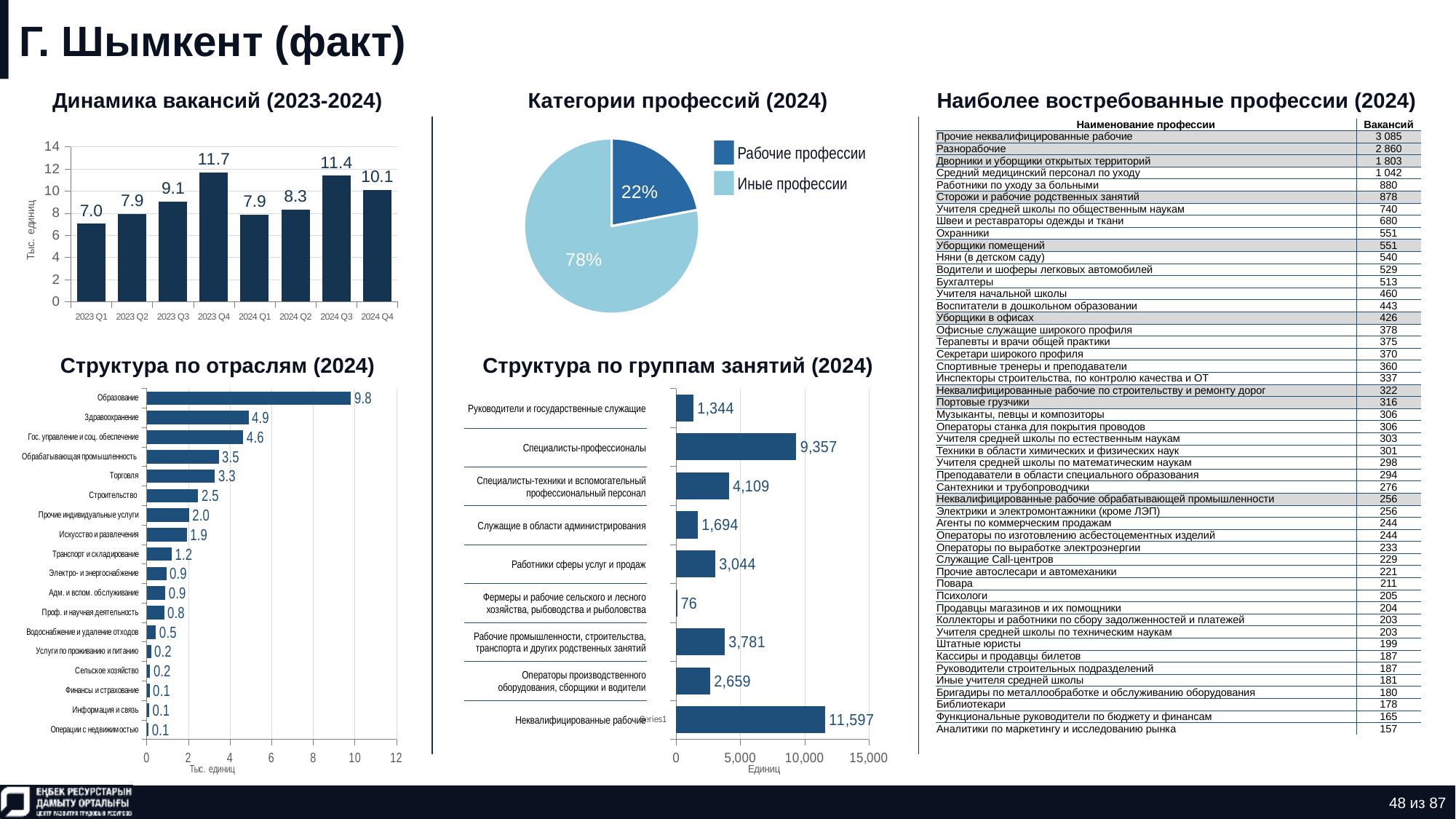
In the chart 'Категории профессий (2024)', how many entries does the legend list? 2 In the chart 'Динамика вакансий (2023-2024)', how many quarters are plotted? 8 In the chart 'Структура по отраслям (2024)', what is the value for 'Здравоохранение'? 4.9 In the chart 'Структура по отраслям (2024)', which category has the highest value? Образование In the chart 'Категории профессий (2024)', what share of the pie is 'Рабочие профессии'? 22% What kind of chart is 'Категории профессий (2024)'? Pie chart In the chart 'Динамика вакансий (2023-2024)', what is the value for 2023 Q4? 11.7 In the chart 'Структура по группам занятий (2024)', which category has the lowest value? Фермеры и рабочие сельского и лесного хозяйства, рыбоводства и рыболовства In the chart 'Динамика вакансий (2023-2024)', which quarter has the lowest value? 2023 Q1 In the chart 'Структура по группам занятий (2024)', which is larger: 'Работники сферы услуг и продаж' or 'Операторы производственного оборудования, сборщики и водители'? Работники сферы услуг и продаж In the chart 'Структура по группам занятий (2024)', what is the value for 'Специалисты-профессионалы'? 9,357 In the chart 'Динамика вакансий (2023-2024)', what is the difference between 2024 Q3 and 2024 Q4? 1.3